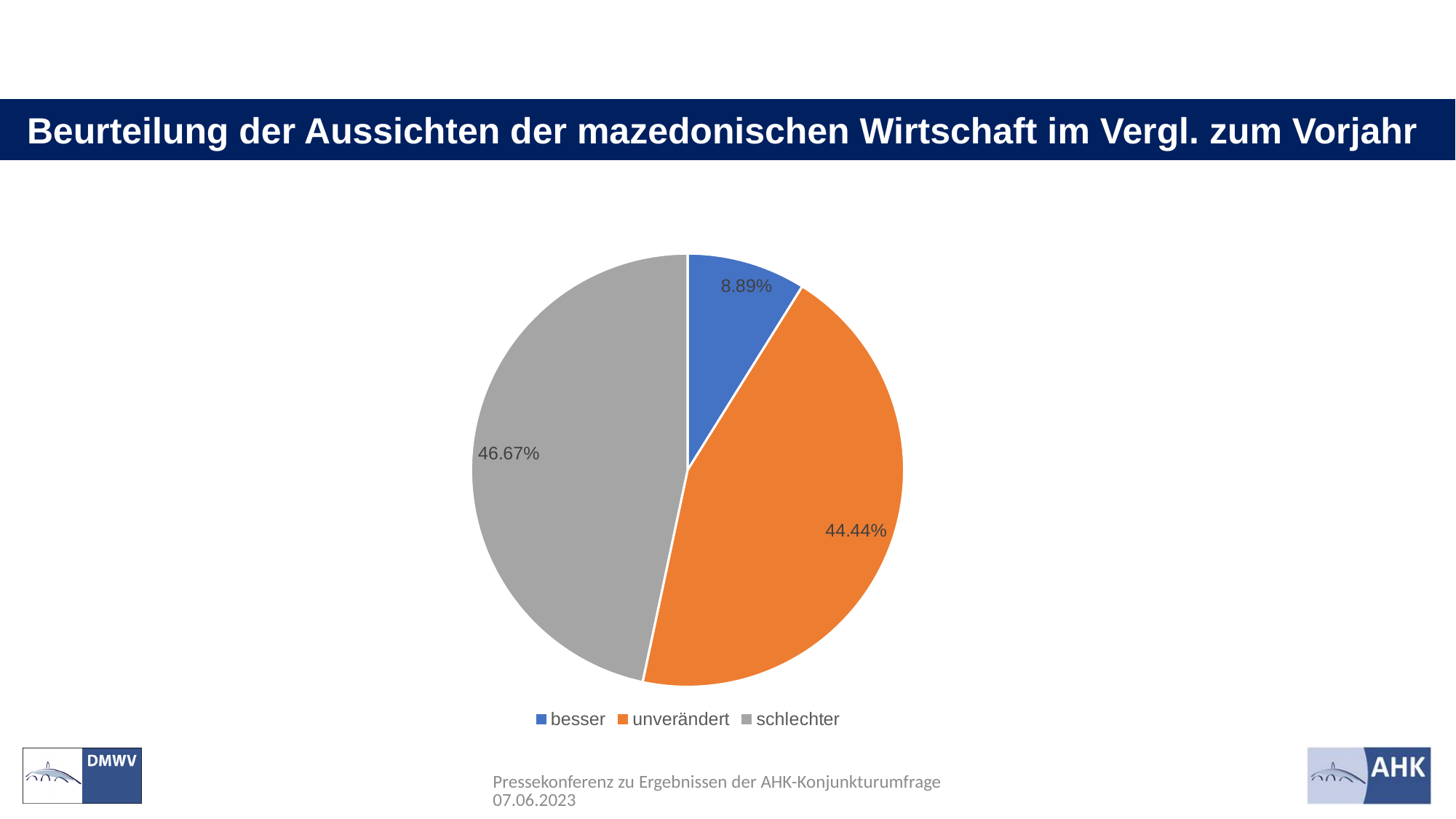
Which category has the smallest share of the pie? besser What kind of chart is shown on the slide? pie chart What is the share for "besser"? 8.89% How many slices does the pie chart have? 3 Which is larger, the share for "unverändert" or the share for "besser"? unverändert Which category has the largest share of the pie? schlechter What is the difference in percentage points between "schlechter" and "unverändert"? 2.23 What is the share for "schlechter"? 46.67% What is the difference in percentage points between "unverändert" and "besser"? 35.55 How many entries does the legend list? 3 Which colour represents "schlechter" in the pie chart? grey What is the share for "unverändert"? 44.44%